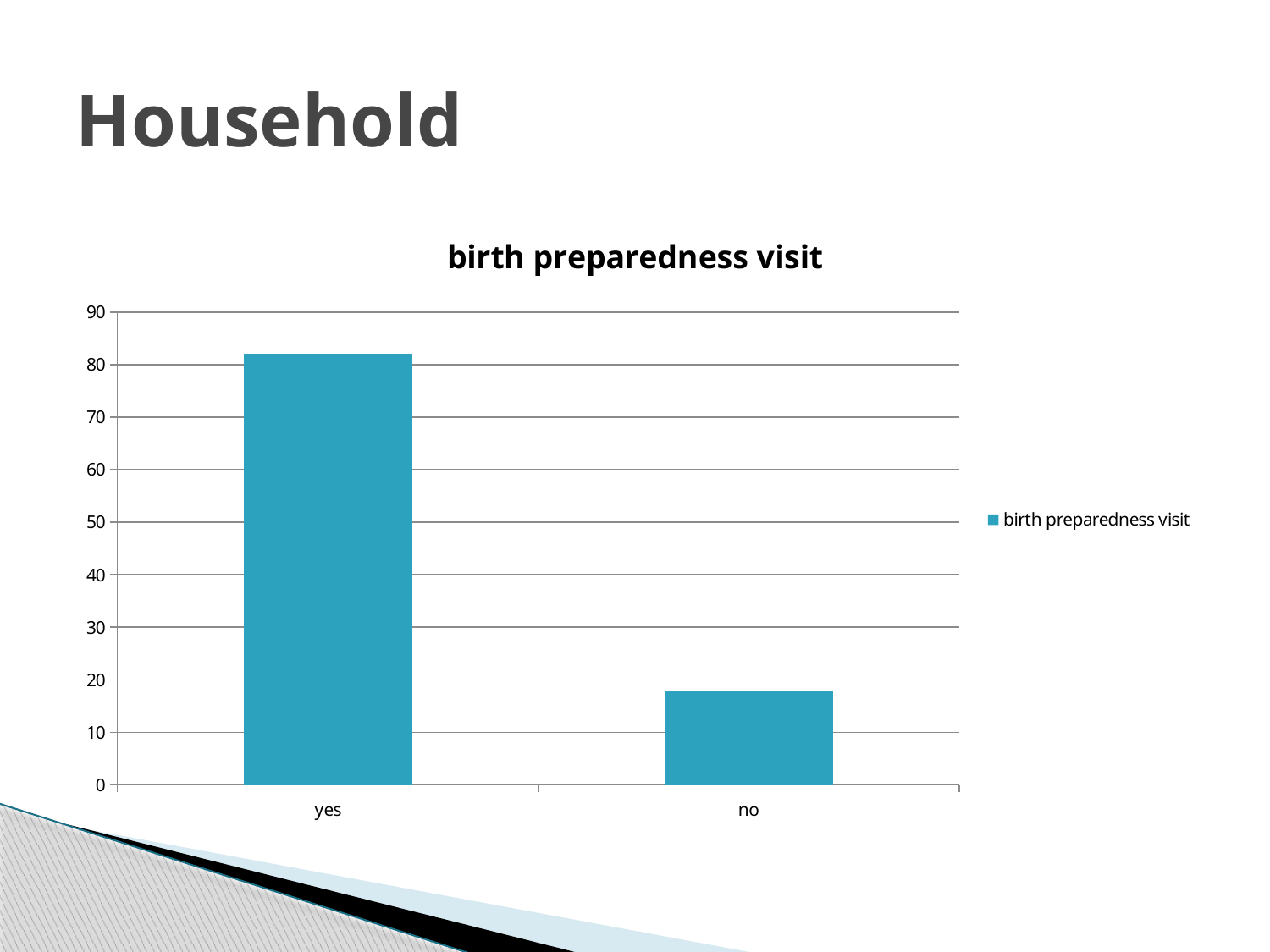
Which category has the lowest value? no Is the value for no greater or less than 10? greater What is the name of the series listed in the legend? birth preparedness visit What is the title of the chart? birth preparedness visit Which is larger, the value for yes or the value for no? yes What kind of chart is shown on the slide? bar chart Is the value for no greater or less than 20? less How many series does the legend list? 1 Is the value for yes greater or less than 90? less How many categories are shown on the x axis of the chart? 2 Which category has the highest value? yes